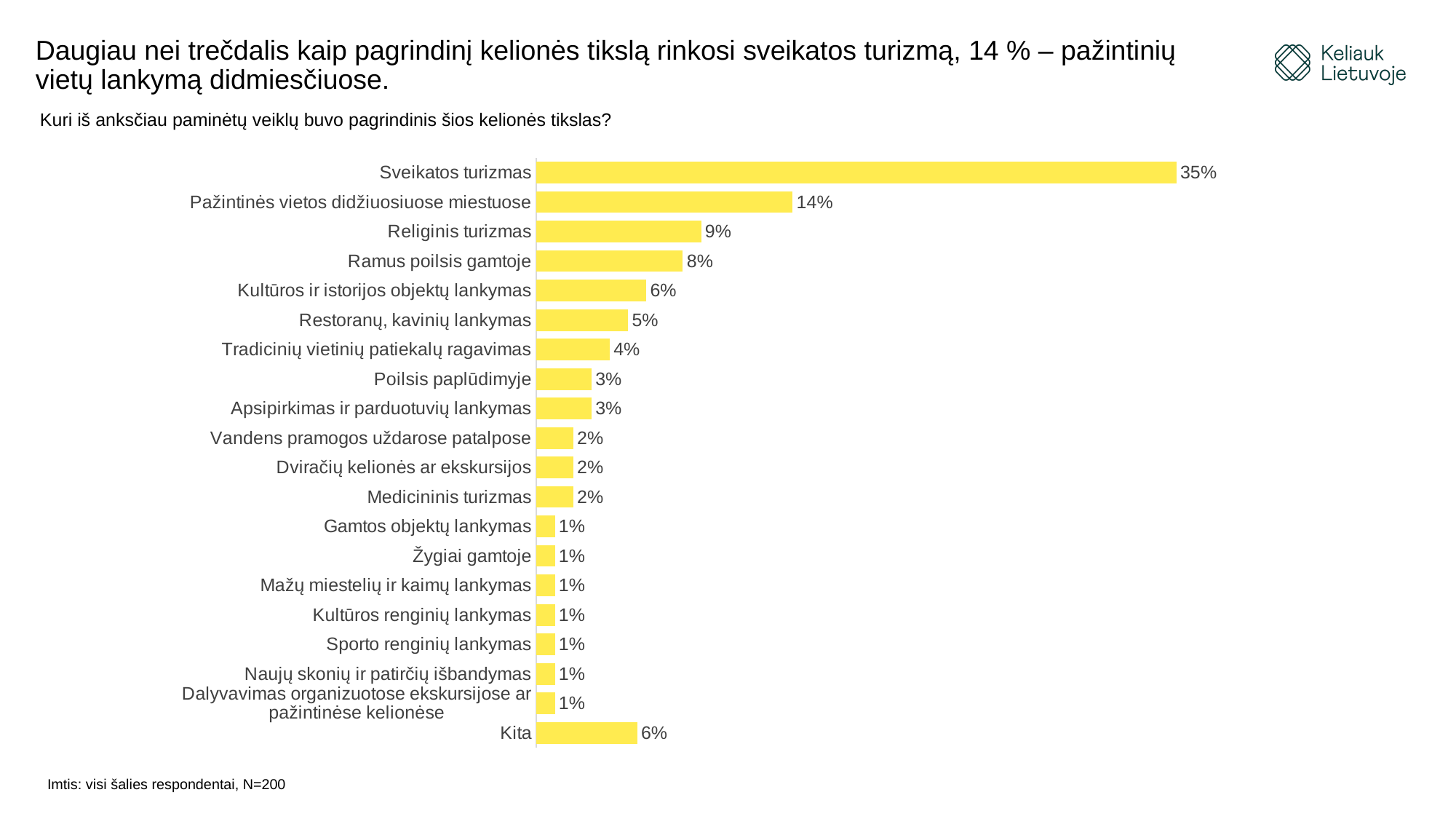
What is the difference between the values for Sveikatos turizmas and Pažintinės vietos didžiuosiuose miestuose? 21% What is the value for Sveikatos turizmas? 35% How many categories are shown in the chart? 20 Which is larger, the value for Religinis turizmas or the value for Kultūros ir istorijos objektų lankymas? Religinis turizmas What is the value for Medicininis turizmas? 2% What is the difference between the values for Ramus poilsis gamtoje and Restoranų, kavinių lankymas? 3% Which category has the highest value? Sveikatos turizmas What is the value for Pažintinės vietos didžiuosiuose miestuose? 14% What colour are the bars in the chart? Yellow What is the value for Kita? 6% What is the value for Religinis turizmas? 9% What kind of chart is shown on the slide? Bar chart